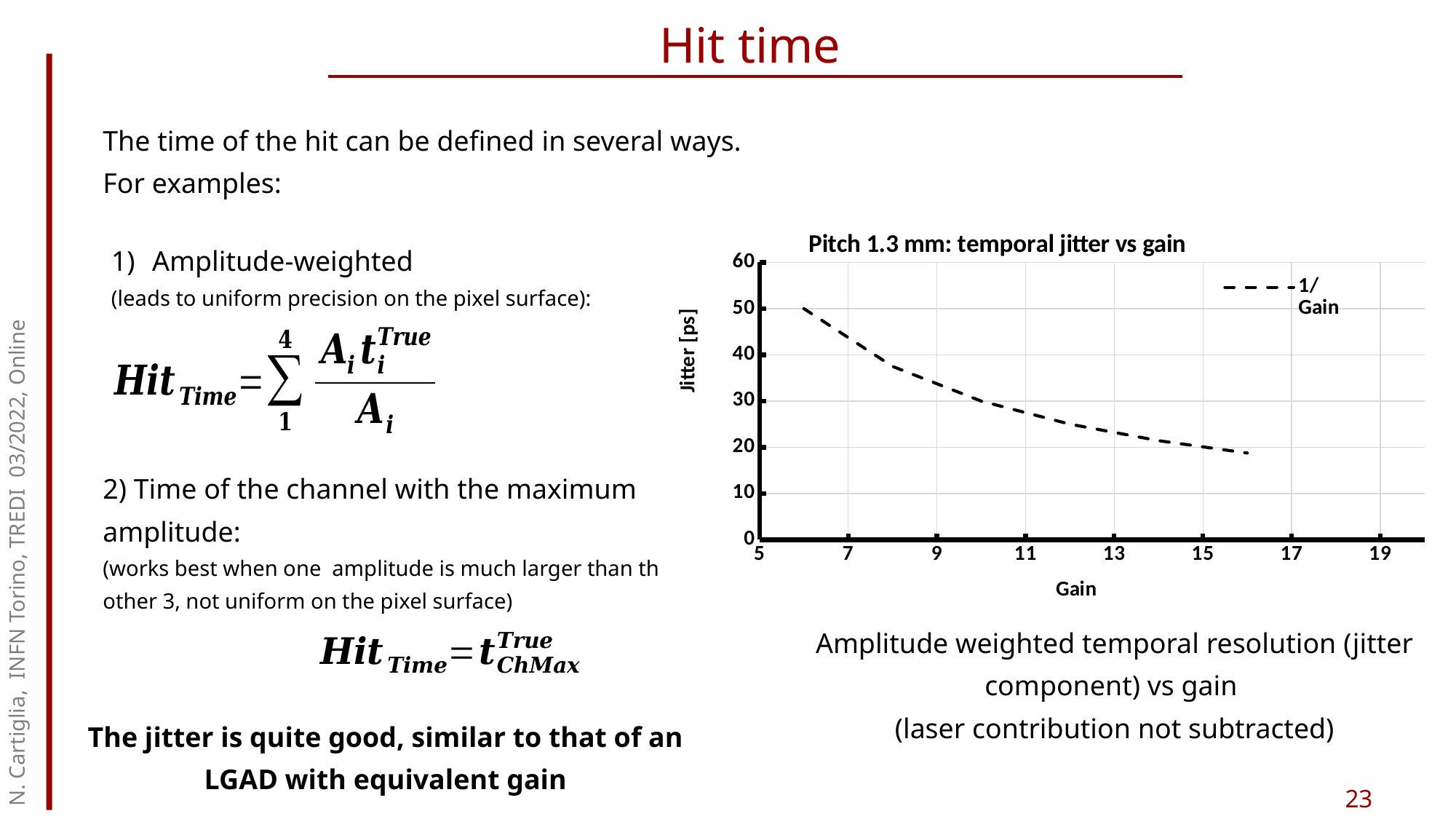
Is the jitter value at a gain of 16 greater or less than 30 ps? less How many series does the chart legend list? 1 Which gain value has the higher jitter, 6 or 16? 6 What is the legend entry for the dashed line in the chart? 1/Gain Does the jitter rise or fall as gain increases along the x axis? fall What is the title of the chart? Pitch 1.3 mm: temporal jitter vs gain Is the jitter value at a gain of 6 greater or less than 40 ps? greater Is the jitter value at a gain of 12 greater or less than 20 ps? greater What kind of chart is shown on the slide? line chart At which end of the gain range is the jitter lowest, the low-gain end or the high-gain end? high-gain end